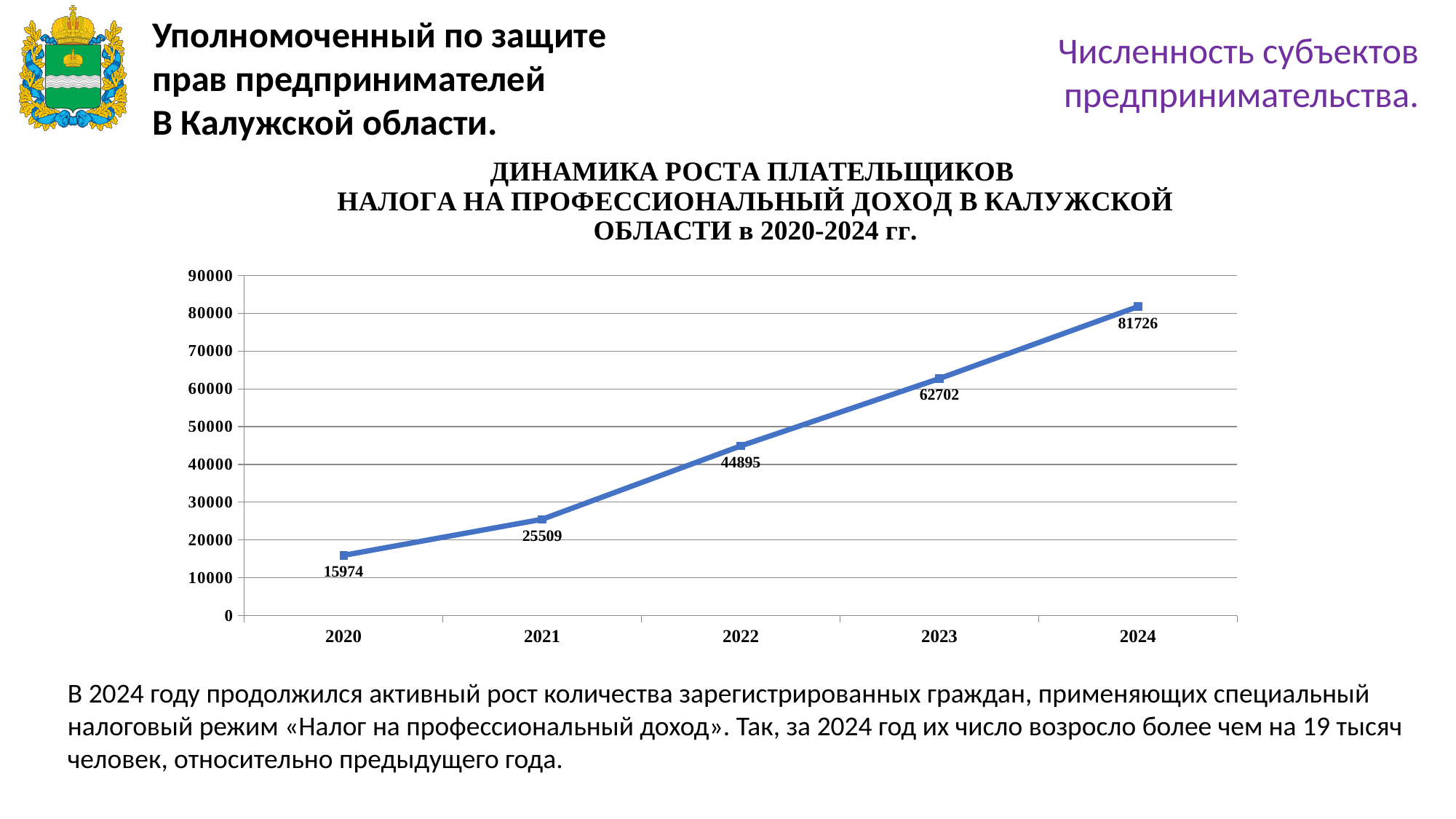
Which is larger, the value for 2022 or the value for 2023? 2023 Which year has the highest value? 2024 How many years are plotted on the chart? 5 Do the values rise or fall from 2020 to 2024? rise What is the difference between the values for 2024 and 2023? 19024 What is the value for 2022? 44895 What kind of chart is shown on the slide? line chart What is the difference between the values for 2021 and 2020? 9535 Is the value for 2021 greater or less than 30000? less What is the value for 2020? 15974 What is the value for 2024? 81726 Which year has the lowest value? 2020